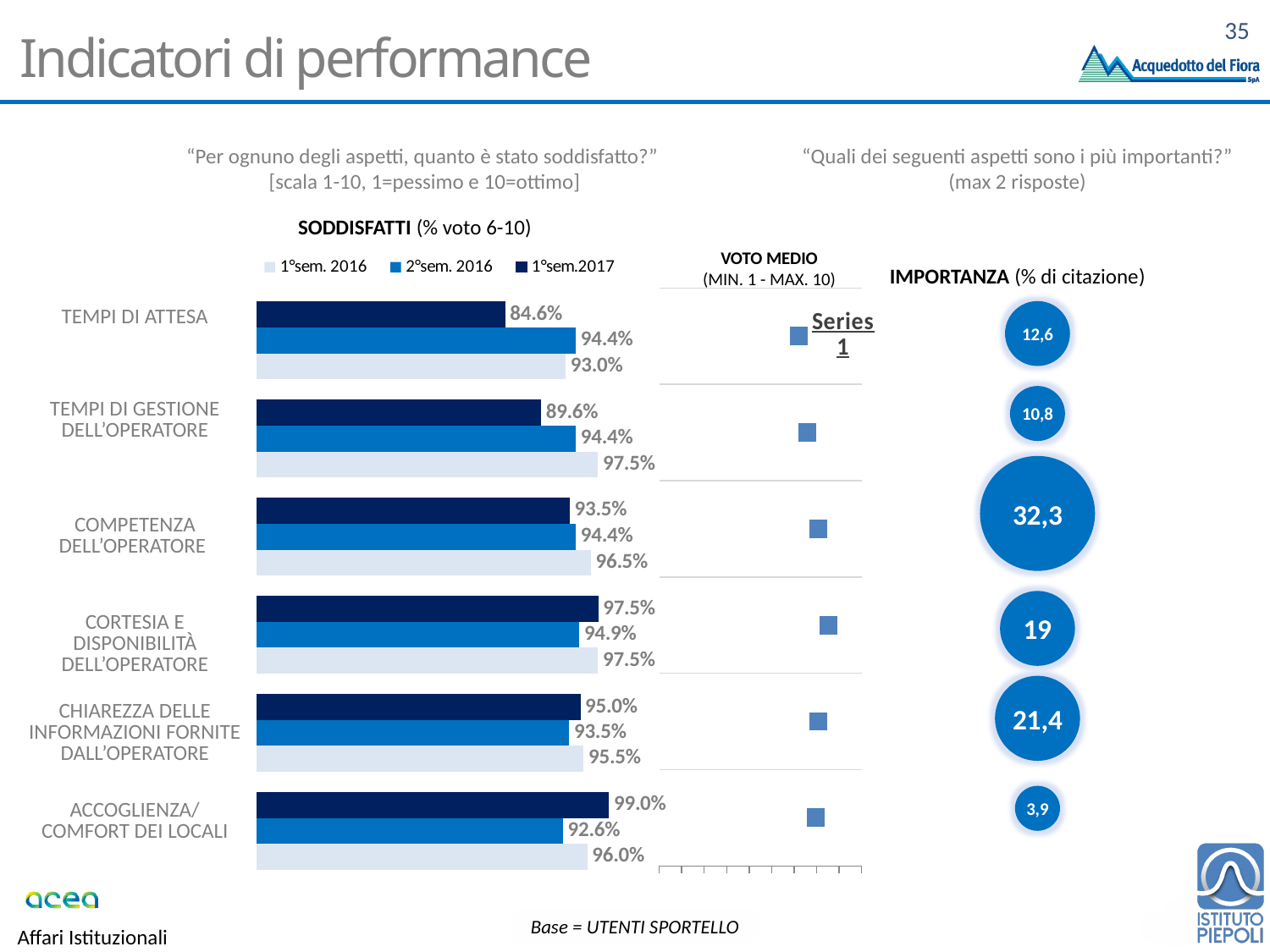
How many categories are shown in the SODDISFATTI chart? 6 In the SODDISFATTI chart, what is the value for TEMPI DI GESTIONE DELL'OPERATORE in 1°sem. 2016? 97.5% In the SODDISFATTI chart, what is the difference between the 2°sem. 2016 and 1°sem.2017 values for TEMPI DI ATTESA? 9.8% In the IMPORTANZA (% di citazione) chart, which aspect has the highest value? COMPETENZA DELL'OPERATORE In the SODDISFATTI chart, which is larger for COMPETENZA DELL'OPERATORE: the 1°sem. 2016 value or the 1°sem.2017 value? 1°sem. 2016 How many series does the legend of the SODDISFATTI chart list? 3 What kind of chart is the SODDISFATTI chart? Bar chart In the SODDISFATTI chart, what is the value for ACCOGLIENZA/COMFORT DEI LOCALI in 2°sem. 2016? 92.6% In the SODDISFATTI chart, which category has the lowest value for 1°sem.2017? TEMPI DI ATTESA In the SODDISFATTI chart, what is the value for TEMPI DI ATTESA in 1°sem.2017? 84.6% In the IMPORTANZA (% di citazione) chart, what is the value for ACCOGLIENZA/COMFORT DEI LOCALI? 3,9 In the SODDISFATTI chart, which category has the highest value for 1°sem.2017? ACCOGLIENZA/COMFORT DEI LOCALI